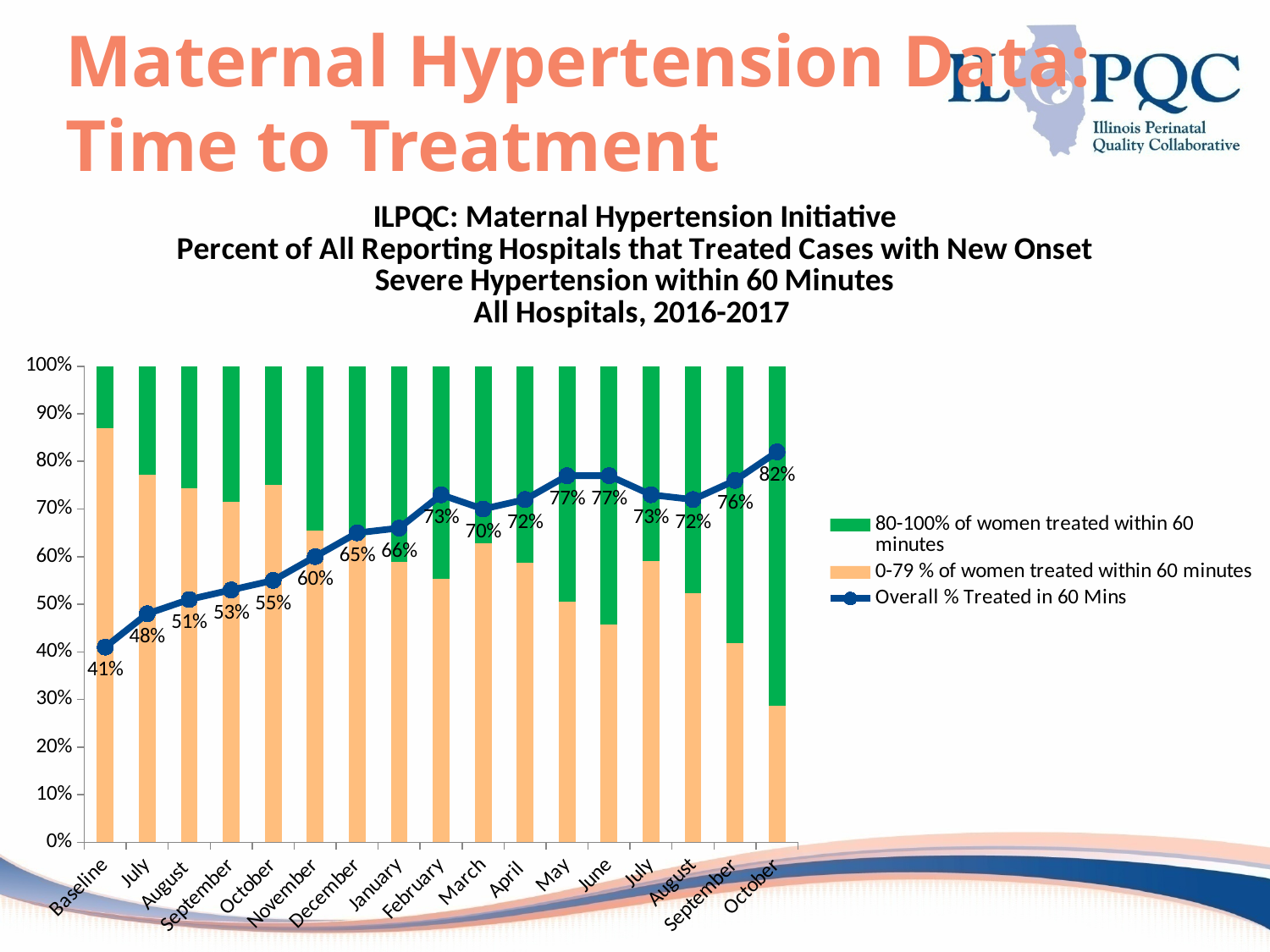
What is the Overall % Treated in 60 Mins value for November? 60% By how many percentage points does the Overall % Treated in 60 Mins value for February exceed the value for March? 3 percentage points Does the Overall % Treated in 60 Mins line generally rise or fall from Baseline to the final October? Rise How many series does the legend list? 3 What is the highest value shown on the Overall % Treated in 60 Mins line? 82% Which category has the lowest Overall % Treated in 60 Mins value? Baseline What is the Overall % Treated in 60 Mins value for February? 73% What is the Overall % Treated in 60 Mins value at Baseline? 41% How many categories are shown along the x axis? 17 What kind of chart is shown on the slide? Stacked bar chart with a line Which has the larger Overall % Treated in 60 Mins value, April or May? May Is the value of the '0-79 % of women treated within 60 minutes' segment at Baseline greater or less than 80%? greater